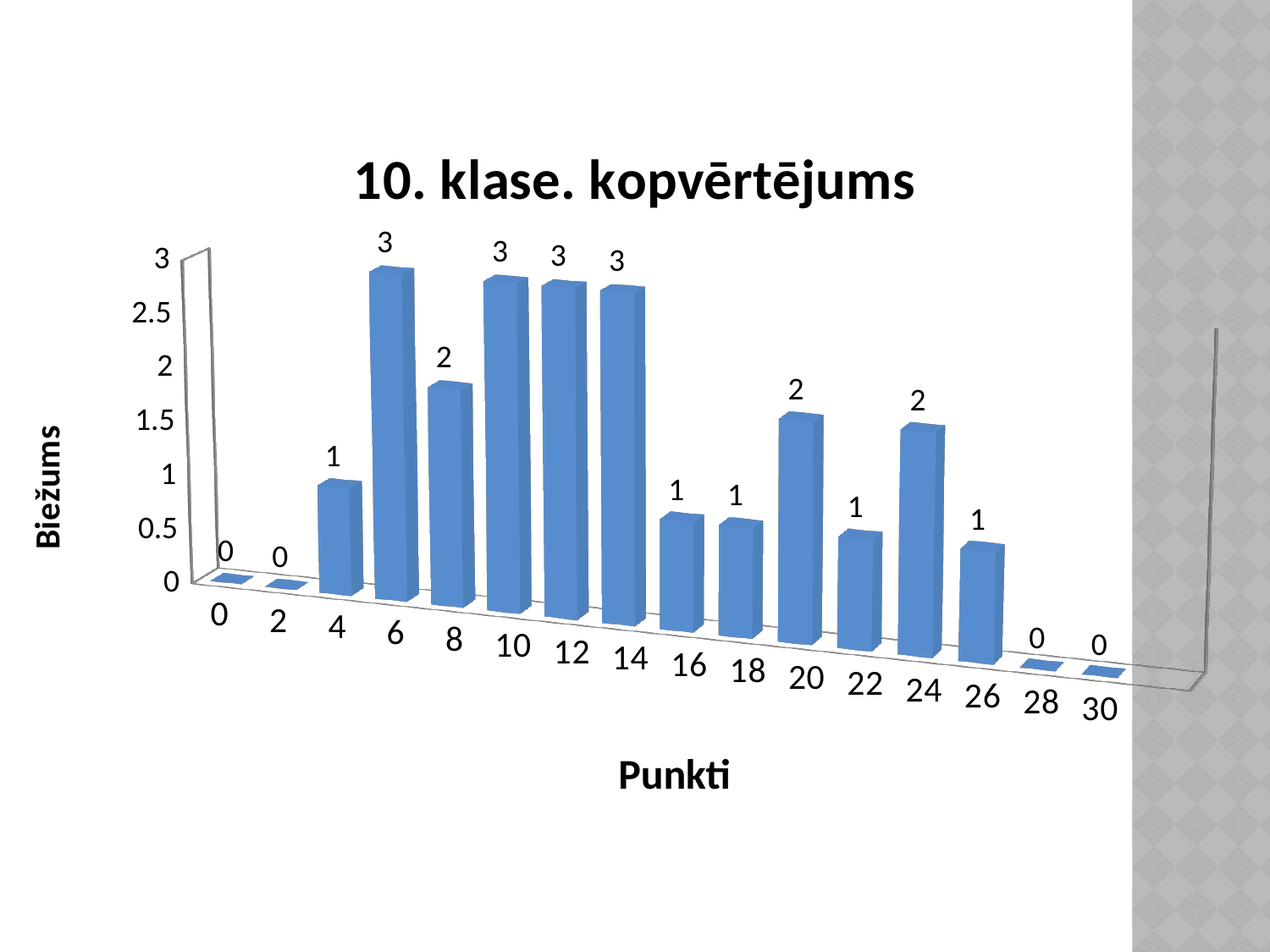
What is the title of the chart? 10. klase. kopvērtējums What is the value for the category 8? 2 How many categories are shown on the x axis? 16 What is the highest value shown in the chart? 3 Which has a larger value, category 8 or category 16? 8 What is the label of the x axis? Punkti What is the value for the category 24? 2 What type of chart is shown on the slide? bar chart What is the difference between the values for categories 6 and 4? 2 What is the value for the category 6? 3 How many categories have a value of 3? 4 What is the value for the category 28? 0